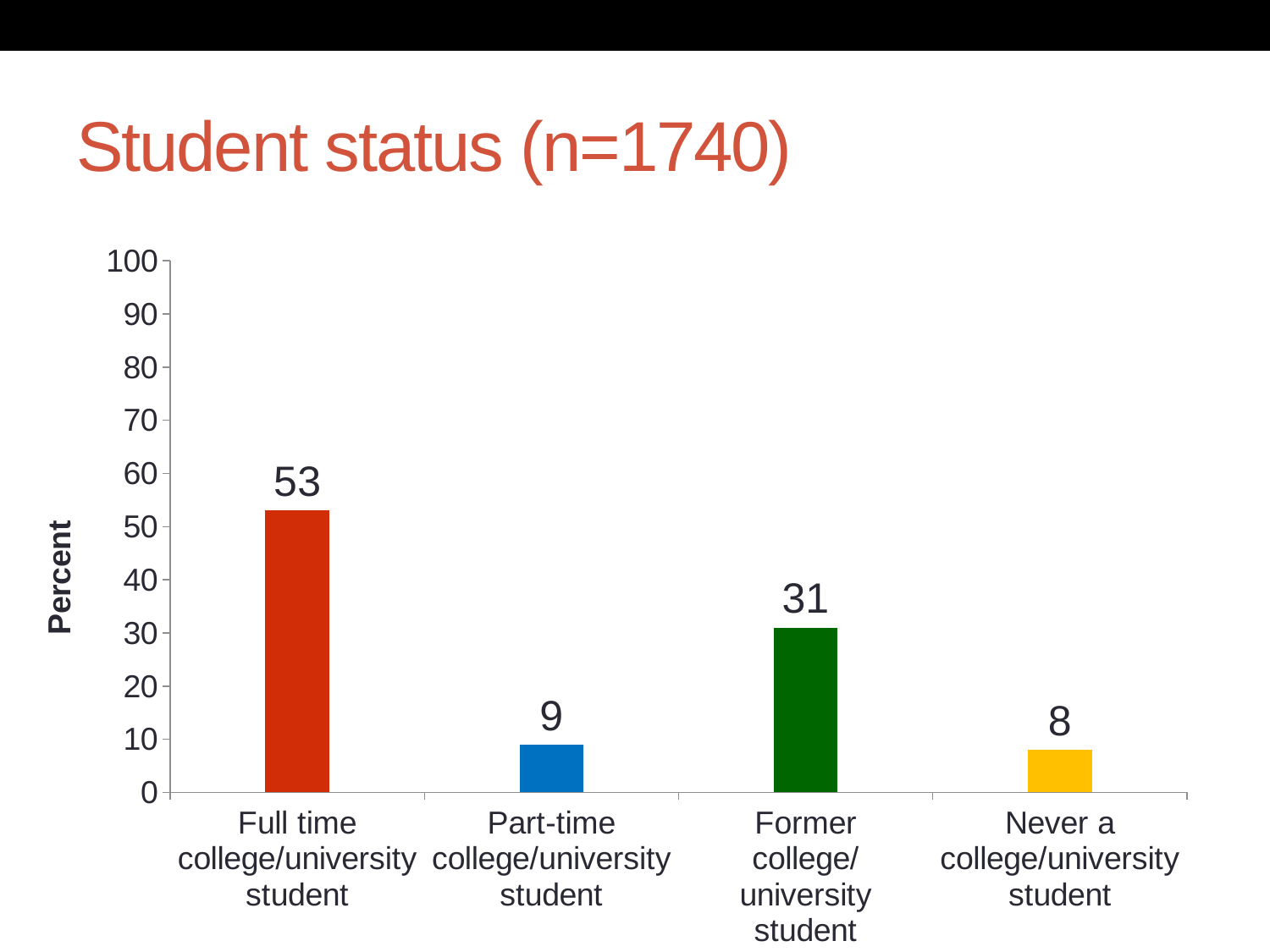
What is the value for Former college/university student? 31 What is the label of the vertical axis? Percent What is the value for Never a college/university student? 8 Is the value for Full time college/university student greater or less than 50? greater Which category has the lowest value? Never a college/university student How many categories are shown on the x axis? 4 What is the value for Full time college/university student? 53 What kind of chart is shown on the slide? bar chart What is the difference between the values for Full time college/university student and Former college/university student? 22 Which is larger, the value for Part-time college/university student or Former college/university student? Former college/university student What is the value for Part-time college/university student? 9 Which category has the highest value? Full time college/university student